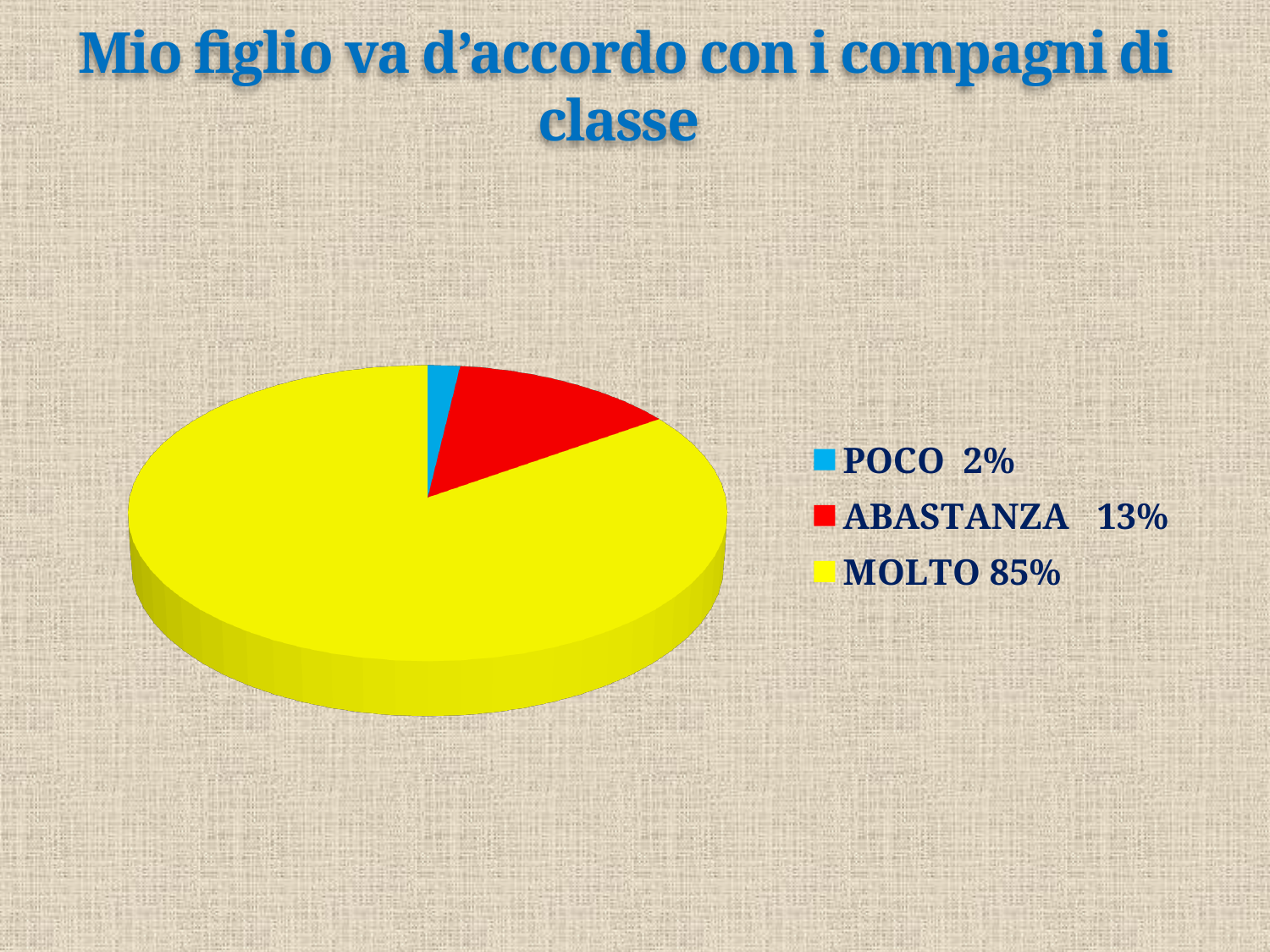
What percentage is shown for POCO? 2% What percentage is shown for ABASTANZA? 13% Which is larger, the share for ABASTANZA or the share for POCO? ABASTANZA What is the difference in percentage points between MOLTO and ABASTANZA? 72 What is the difference in percentage points between ABASTANZA and POCO? 11 Which category has the largest share of the pie? MOLTO What kind of chart is shown on the slide? pie chart How many categories does the pie chart have? 3 What colour is the slice for MOLTO? yellow Which category has the smallest share of the pie? POCO What percentage is shown for MOLTO? 85% What is the title of the slide? Mio figlio va d'accordo con i compagni di classe